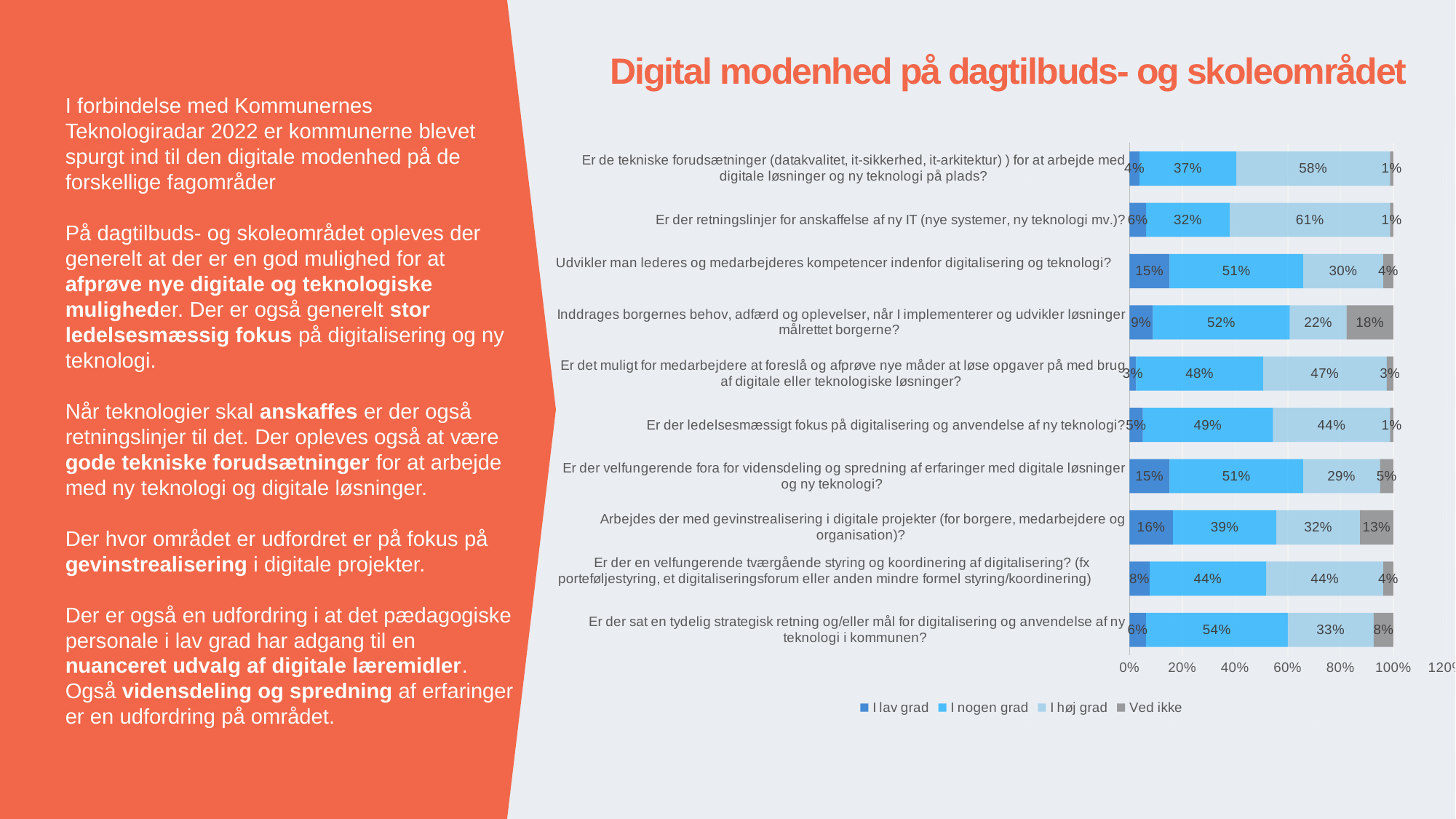
Which question has the highest 'I lav grad' share? Arbejdes der med gevinstrealisering i digitale projekter (for borgere, medarbejdere og organisation)? What type of chart is shown on the slide? Stacked bar chart What is the title of the chart? Digital modenhed på dagtilbuds- og skoleområdet How many series does the legend list? 4 What is the 'I høj grad' value for 'Er der retningslinjer for anskaffelse af ny IT (nye systemer, ny teknologi mv.)?' 61% How many questions (categories) are plotted in the chart? 10 What is the 'Ved ikke' value for 'Inddrages borgernes behov, adfærd og oplevelser, når I implementerer og udvikler løsninger målrettet borgerne?' 18% Which is larger: the 'I nogen grad' value for 'Arbejdes der med gevinstrealisering i digitale projekter' or for 'Er der ledelsesmæssigt fokus på digitalisering og anvendelse af ny teknologi?' Er der ledelsesmæssigt fokus på digitalisering og anvendelse af ny teknologi? What is the 'I nogen grad' value for 'Er der sat en tydelig strategisk retning og/eller mål for digitalisering og anvendelse af ny teknologi i kommunen?' 54% Which question has the highest 'I høj grad' share? Er der retningslinjer for anskaffelse af ny IT (nye systemer, ny teknologi mv.)? What is the difference between the 'I høj grad' value for 'Er de tekniske forudsætninger ... på plads?' (58%) and for 'Udvikler man lederes og medarbejderes kompetencer indenfor digitalisering og teknologi?' (30%)? 28% Which question has the highest 'Ved ikke' share? Inddrages borgernes behov, adfærd og oplevelser, når I implementerer og udvikler løsninger målrettet borgerne?